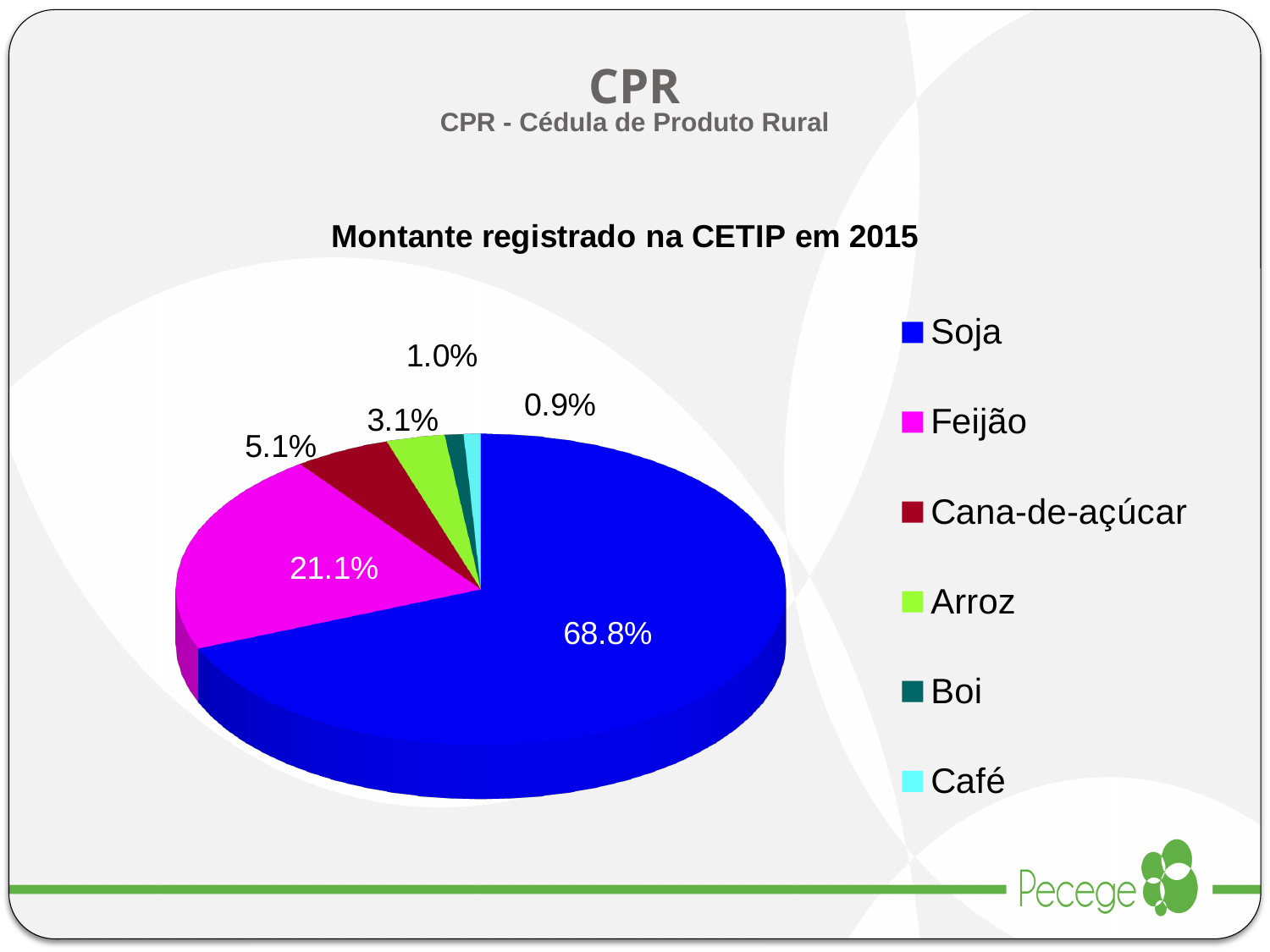
Which is larger, the share for Cana-de-açúcar or the share for Arroz? Cana-de-açúcar What is the title of the chart? Montante registrado na CETIP em 2015 How many categories does the legend list? 6 Which category has the largest slice of the pie? Soja What share of the pie does Cana-de-açúcar represent? 5.1% What share of the pie does Soja represent? 68.8% What is the difference in percentage points between Soja and Feijão? 47.7 Which category has the smallest slice of the pie? Café What share of the pie does Arroz represent? 3.1% What share of the pie does Feijão represent? 21.1% What type of chart is shown on the slide? pie chart What share of the pie does Café represent? 0.9%